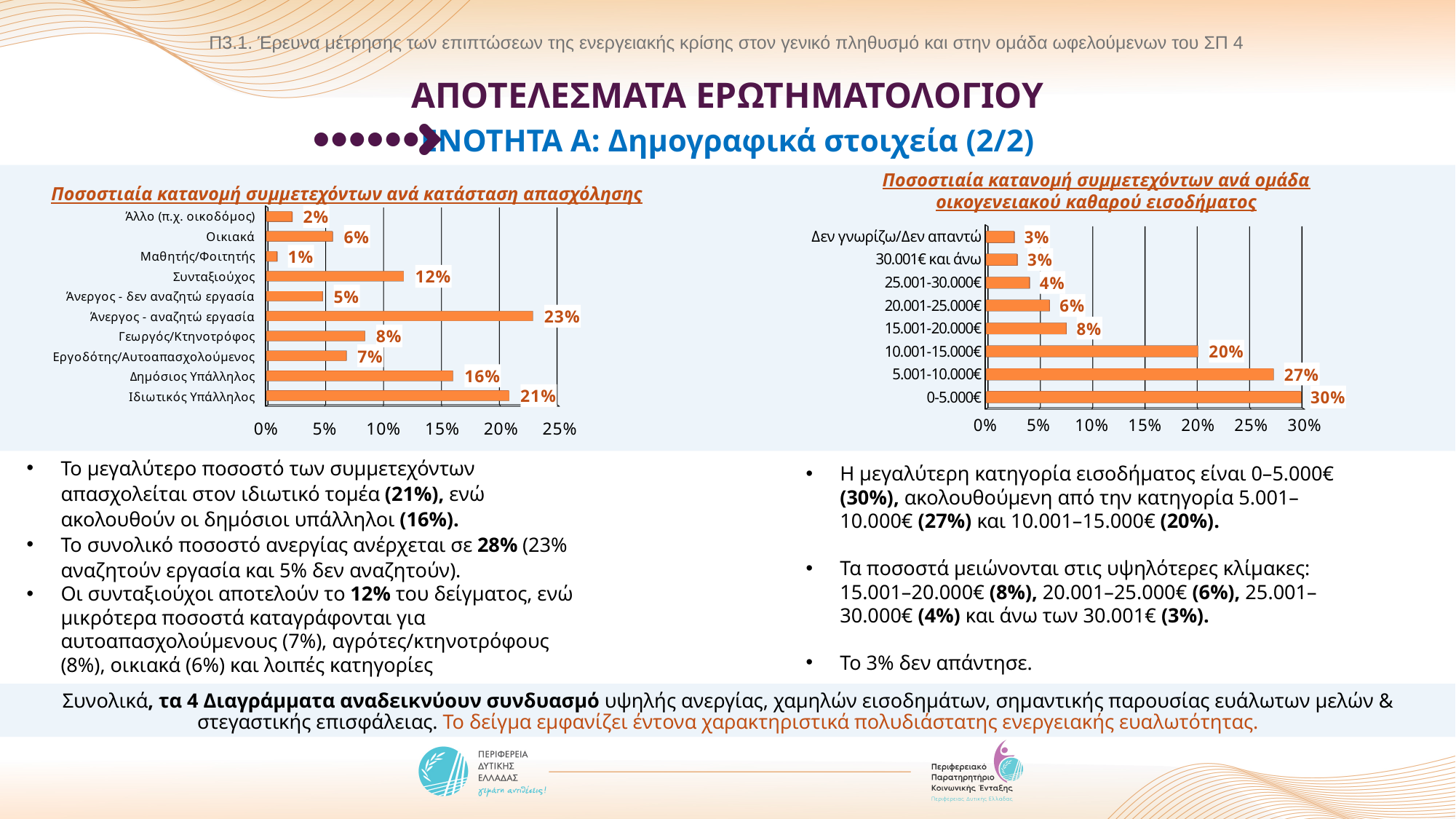
In the left chart (Ποσοστιαία κατανομή συμμετεχόντων ανά κατάσταση απασχόλησης), which is larger: Γεωργός/Κτηνοτρόφος or Εργοδότης/Αυτοαπασχολούμενος? Γεωργός/Κτηνοτρόφος In the right chart (Ποσοστιαία κατανομή συμμετεχόντων ανά ομάδα οικογενειακού καθαρού εισοδήματος), how many income categories are shown? 8 In the left chart (Ποσοστιαία κατανομή συμμετεχόντων ανά κατάσταση απασχόλησης), how many categories are shown? 10 In the right chart (Ποσοστιαία κατανομή συμμετεχόντων ανά ομάδα οικογενειακού καθαρού εισοδήματος), which income group has the highest value? 0-5.000€ In the left chart (Ποσοστιαία κατανομή συμμετεχόντων ανά κατάσταση απασχόλησης), what is the difference between Ιδιωτικός Υπάλληλος and Δημόσιος Υπάλληλος? 5% In the left chart (Ποσοστιαία κατανομή συμμετεχόντων ανά κατάσταση απασχόλησης), which category has the lowest value? Μαθητής/Φοιτητής In the right chart (Ποσοστιαία κατανομή συμμετεχόντων ανά ομάδα οικογενειακού καθαρού εισοδήματος), what is the value for 5.001-10.000€? 27% In the left chart (Ποσοστιαία κατανομή συμμετεχόντων ανά κατάσταση απασχόλησης), which category has the highest value? Άνεργος - αναζητώ εργασία What type of chart is the right chart (Ποσοστιαία κατανομή συμμετεχόντων ανά ομάδα οικογενειακού καθαρού εισοδήματος)? Bar chart In the left chart (Ποσοστιαία κατανομή συμμετεχόντων ανά κατάσταση απασχόλησης), what is the value for Ιδιωτικός Υπάλληλος? 21% In the left chart (Ποσοστιαία κατανομή συμμετεχόντων ανά κατάσταση απασχόλησης), what is the value for Συνταξιούχος? 12% In the right chart (Ποσοστιαία κατανομή συμμετεχόντων ανά ομάδα οικογενειακού καθαρού εισοδήματος), what is the difference between 0-5.000€ and 10.001-15.000€? 10%